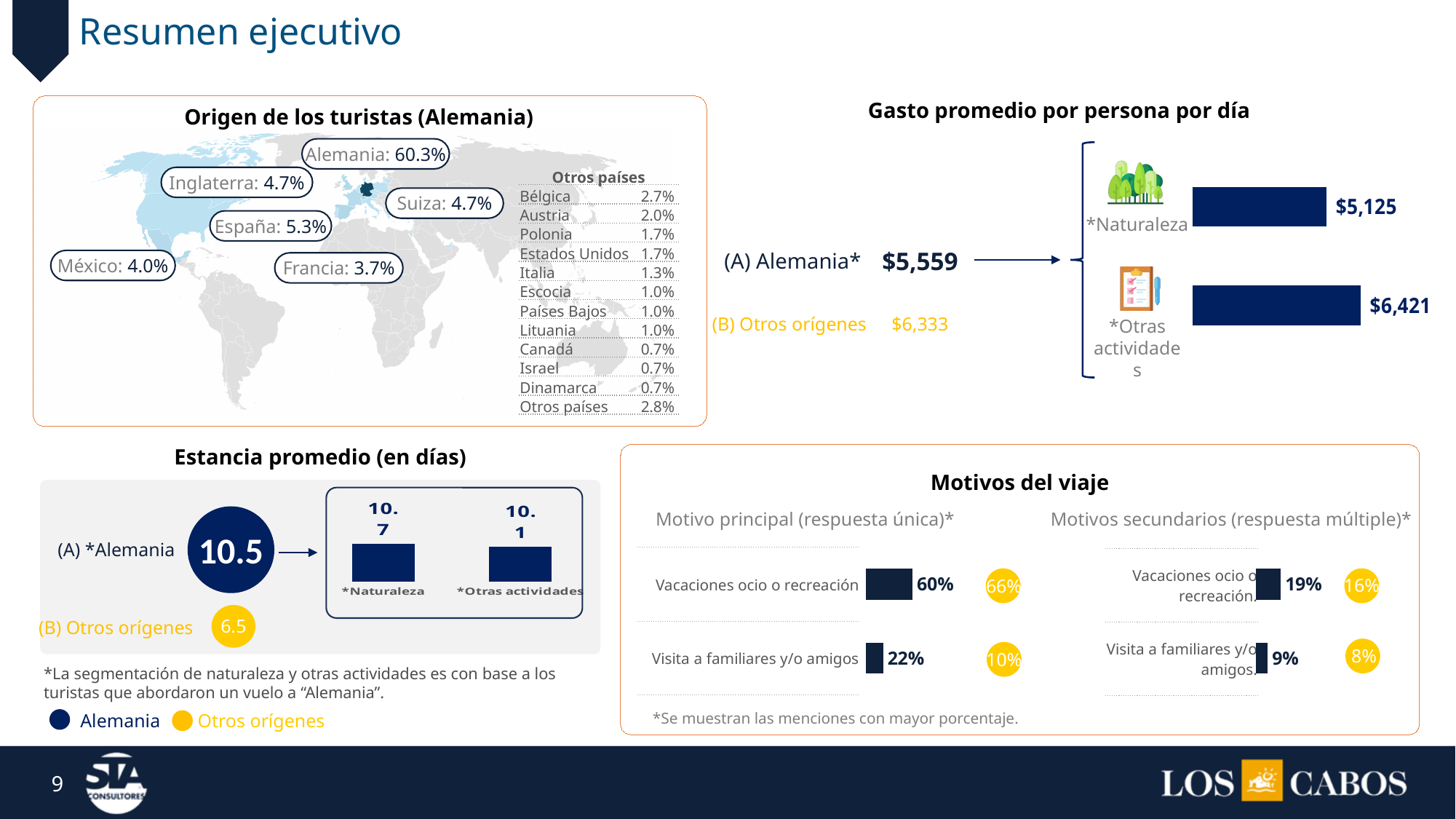
In the 'Estancia promedio (en días)' chart, how many bars are plotted? 2 In the 'Motivos del viaje' chart, what is the Alemania value for 'Vacaciones ocio o recreación' under Motivo principal? 60% What kind of chart is used in the 'Gasto promedio por persona por día' section? Bar chart In the 'Gasto promedio por persona por día' chart, what is the value for *Otras actividades? $6,421 In the 'Motivos del viaje' chart, what is the Alemania value for 'Visita a familiares y/o amigos' under Motivos secundarios? 9% In the 'Gasto promedio por persona por día' chart, what is the value for *Naturaleza? $5,125 In the 'Gasto promedio por persona por día' chart, which category has the higher value, *Naturaleza or *Otras actividades? *Otras actividades In the 'Gasto promedio por persona por día' chart, what is the difference between the *Otras actividades and *Naturaleza values? $1,296 In the 'Estancia promedio (en días)' chart, what is the value for *Naturaleza? 10.7 In the 'Estancia promedio (en días)' chart, which category has the lowest value? *Otras actividades In the 'Estancia promedio (en días)' chart, what is the value for *Otras actividades? 10.1 In the 'Motivos del viaje' chart, what is the difference between the Alemania values for 'Vacaciones ocio o recreación' and 'Visita a familiares y/o amigos' under Motivo principal? 38%